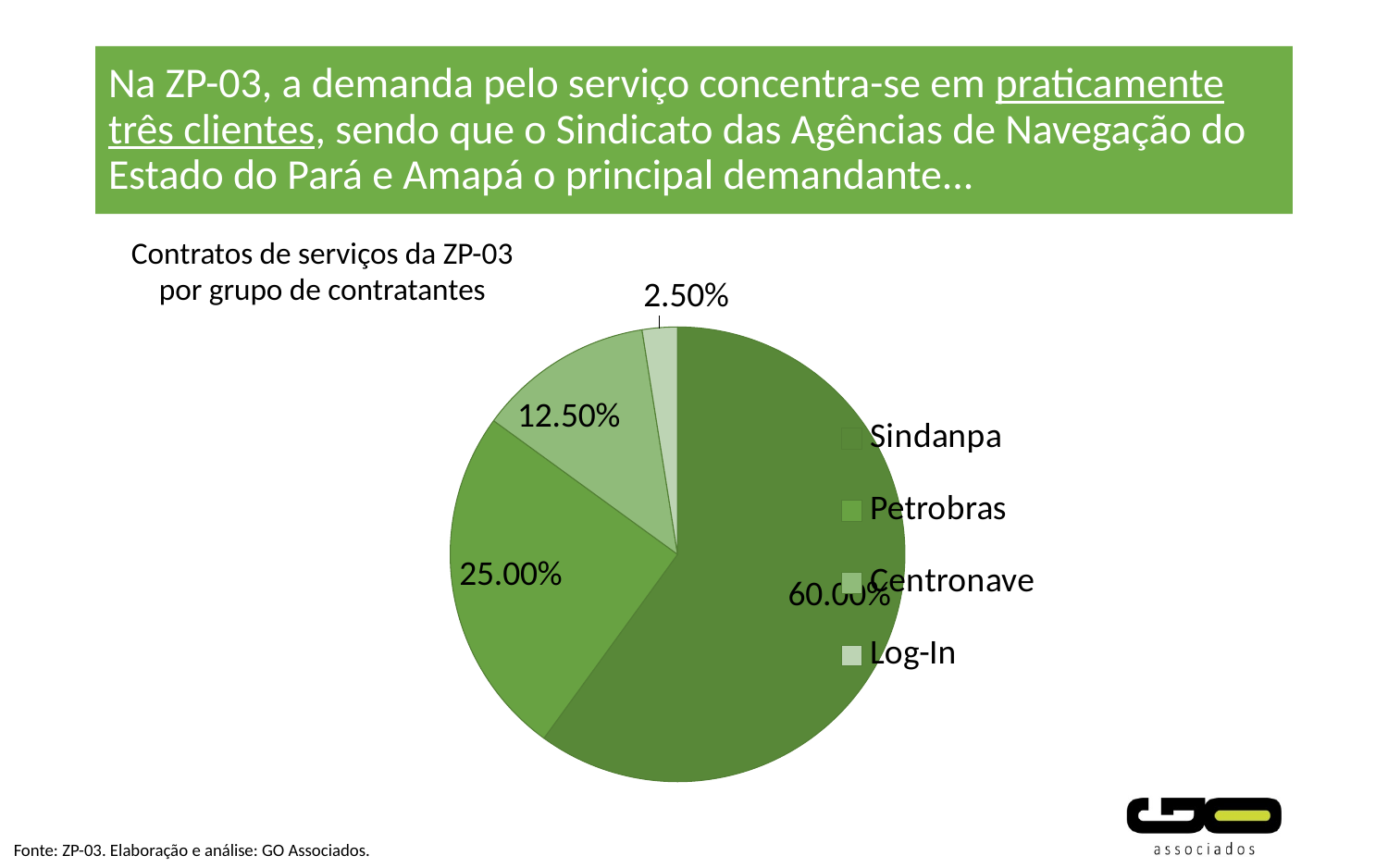
What share of the pie does Petrobras hold? 25.00% What is the difference in percentage points between the Sindanpa and Petrobras slices? 35.00% What share of the pie does Centronave hold? 12.50% Which group has the smallest slice of the pie? Log-In What is the title of the chart? Contratos de serviços da ZP-03 por grupo de contratantes What share of the pie does Sindanpa hold? 60.00% Which slice is larger, Centronave or Log-In? Centronave How many entries does the legend list? 4 Which group has the largest slice of the pie? Sindanpa How many slices does the pie chart have? 4 What kind of chart is shown on the slide? pie chart